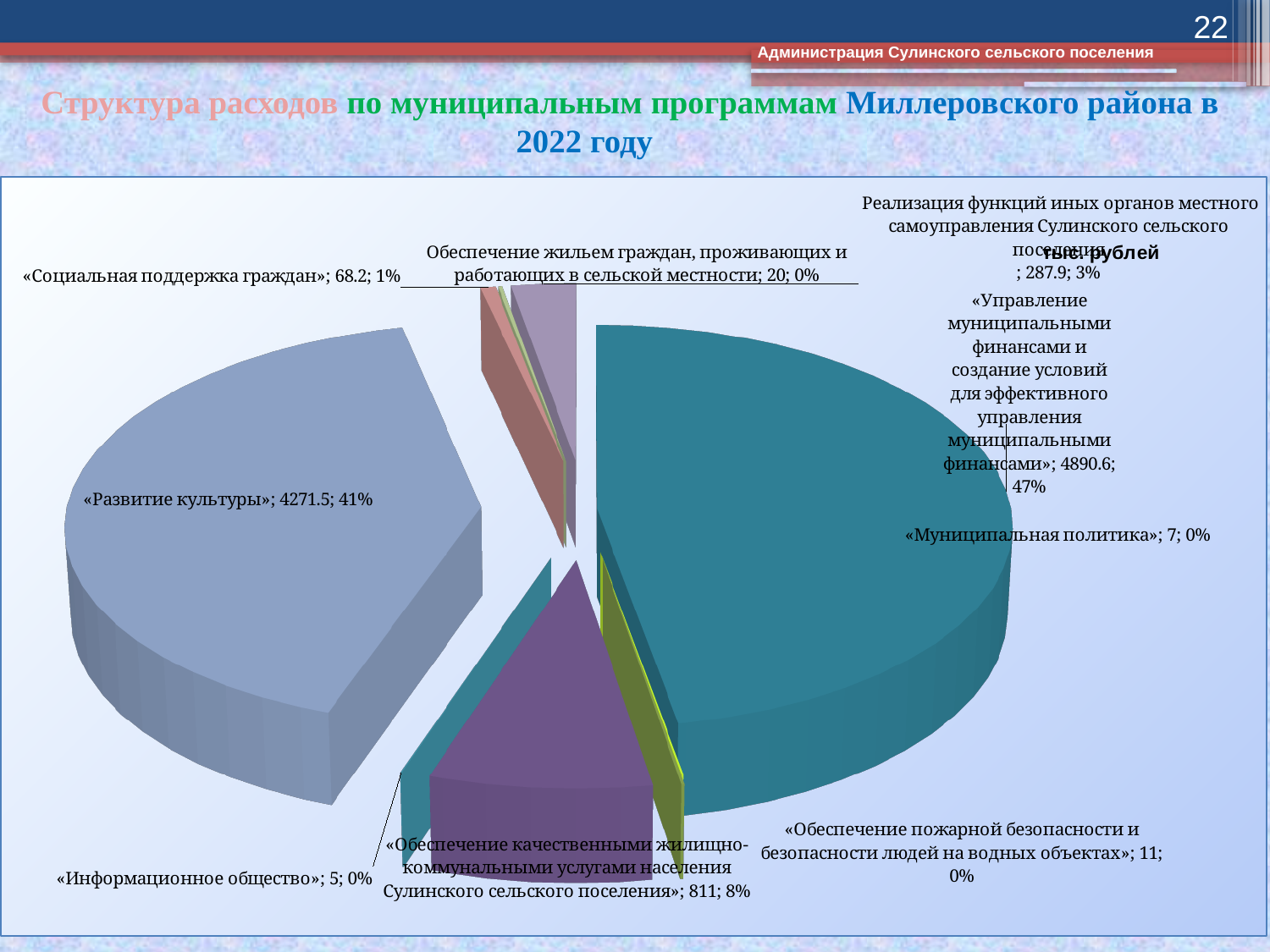
In what units are the values in the chart given? тыс. рублей What is the difference between the values for «Управление муниципальными финансами...» (4890.6) and «Развитие культуры» (4271.5)? 619.1 What is the value for «Развитие культуры»? 4271.5 What share of the pie does «Развитие культуры» represent? 41% What kind of chart is shown on the slide? pie chart Which program has the smallest value in the pie chart? «Информационное общество» What is the value for «Социальная поддержка граждан»? 68.2 How many slices does the pie chart have? 9 What share of the pie does «Реализация функций иных органов местного самоуправления Сулинского сельского поселения» represent? 3% Which program has the largest share of the pie? «Управление муниципальными финансами и создание условий для эффективного управления муниципальными финансами» Which is larger: the value for «Муниципальная политика» or the value for «Обеспечение пожарной безопасности и безопасности людей на водных объектах»? «Обеспечение пожарной безопасности и безопасности людей на водных объектах» What is the value for «Обеспечение качественными жилищно-коммунальными услугами населения Сулинского сельского поселения»? 811